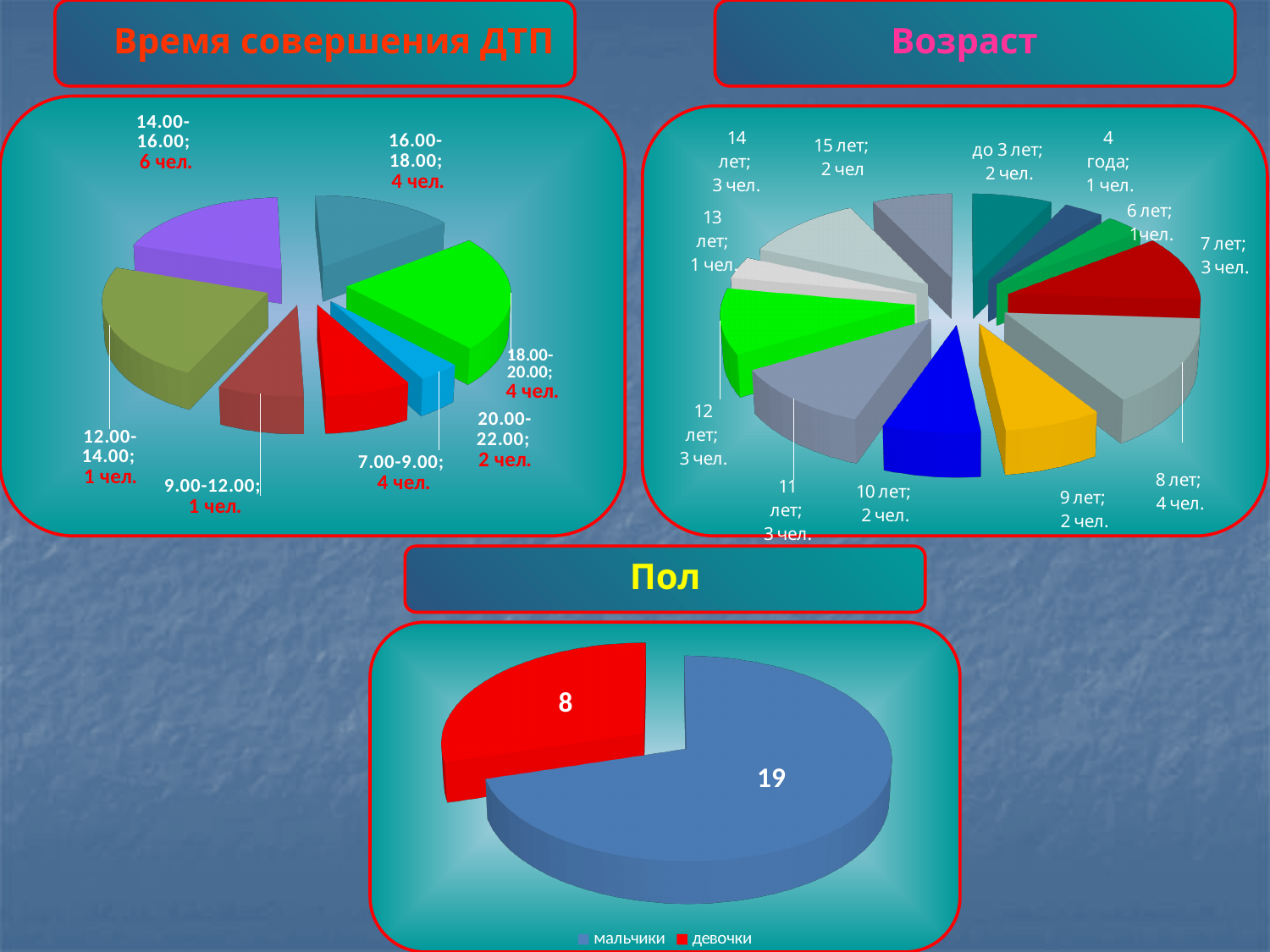
In the 'Возраст' chart, which is larger: the value for 7 лет or the value for 13 лет? 7 лет What type of chart is used for 'Пол'? Pie chart In the 'Пол' chart, what is the value for мальчики? 19 In the 'Время совершения ДТП' chart, what is the difference between the 14.00-16.00 value and the 20.00-22.00 value? 4 In the 'Возраст' chart, how many people are shown for 8 лет? 4 чел. In the 'Время совершения ДТП' chart, which time interval has the largest value? 14.00-16.00 In the 'Пол' chart, what is the total of the two slices? 27 In the 'Время совершения ДТП' chart, how many time intervals are shown? 7 In the 'Время совершения ДТП' chart, how many people are shown for the 14.00-16.00 slice? 6 чел. In the 'Возраст' chart, which age group has the largest value? 8 лет In the 'Возраст' chart, how many age categories are shown? 12 In the 'Пол' chart, how many entries does the legend list? 2